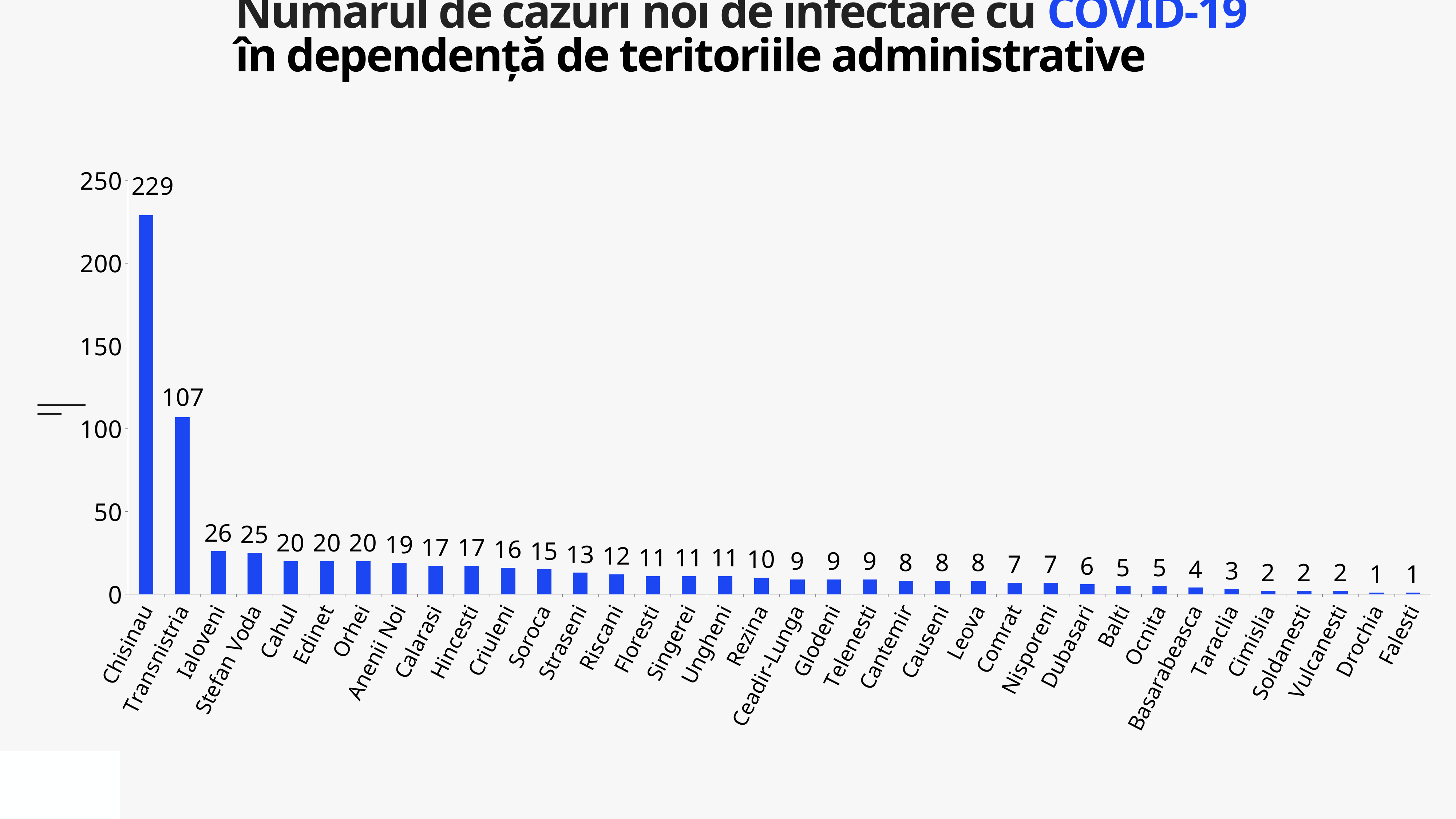
Do the values rise or fall from left to right along the x axis? fall What is the value for Balti? 5 What is the value for Soroca? 15 Which is larger, the value for Cahul or the value for Rezina? Cahul What is the value for Chisinau? 229 What is the value for Ialoveni? 26 What kind of chart is shown on the slide? bar chart What is the value for Transnistria? 107 Is the value for Transnistria greater or less than 100? greater How many territories are shown on the chart? 36 Which territory has the highest number of new cases? Chisinau What is the difference between the values for Chisinau and Transnistria? 122